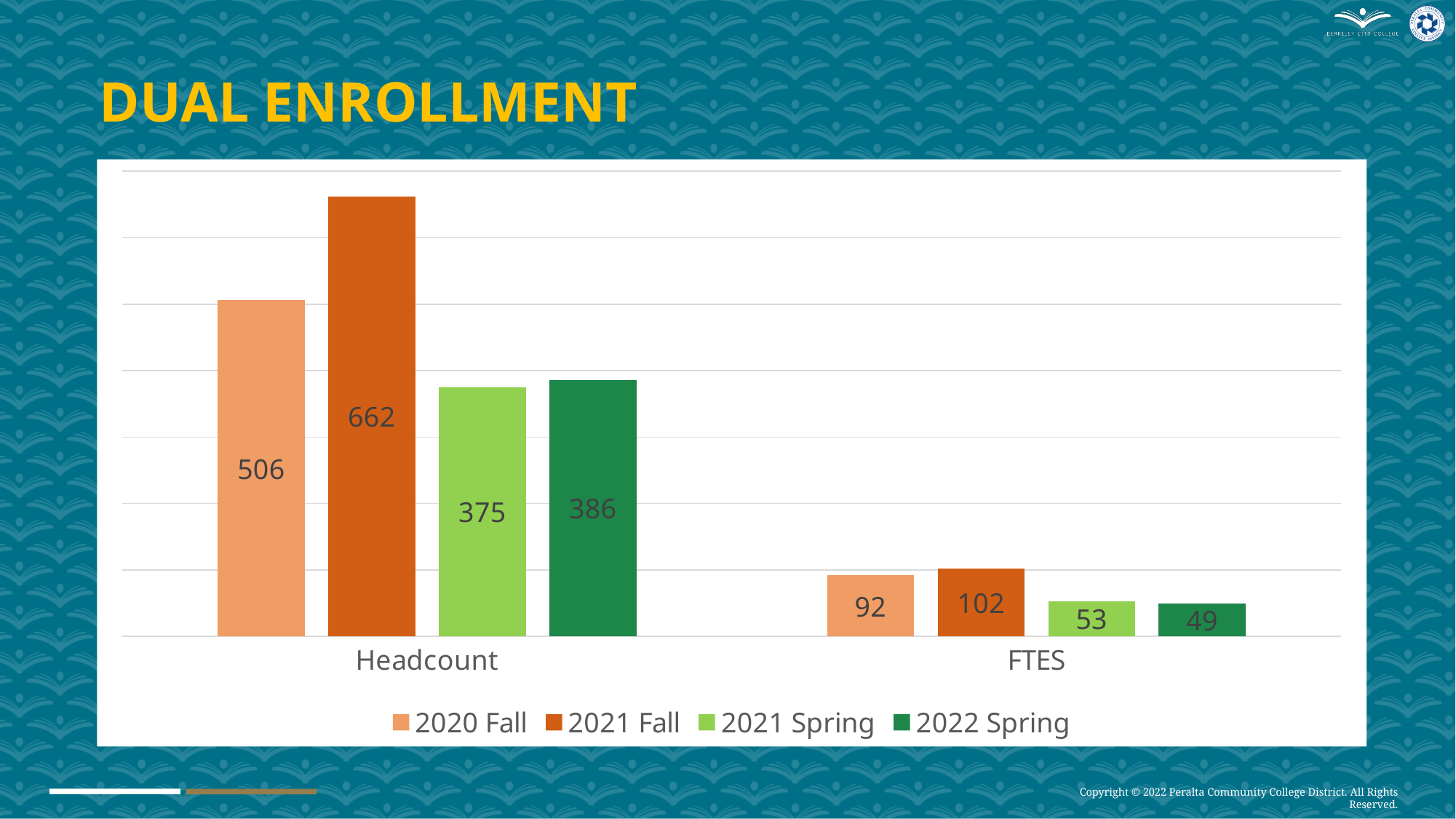
What kind of chart is shown on the slide? Bar chart What is the difference between the 2021 Fall and 2020 Fall Headcount values? 156 What is the title of the slide containing the chart? DUAL ENROLLMENT What is the difference between the 2020 Fall and 2021 Spring FTES values? 39 What is the Headcount value for 2021 Spring? 375 Which series has the highest Headcount? 2021 Fall Which series has the lowest FTES? 2022 Spring Which is larger, the Headcount for 2022 Spring or for 2021 Spring? 2022 Spring What is the FTES value for 2022 Spring? 49 How many categories are shown on the x axis? 2 How many series does the legend list? 4 What is the Headcount value for 2021 Fall? 662